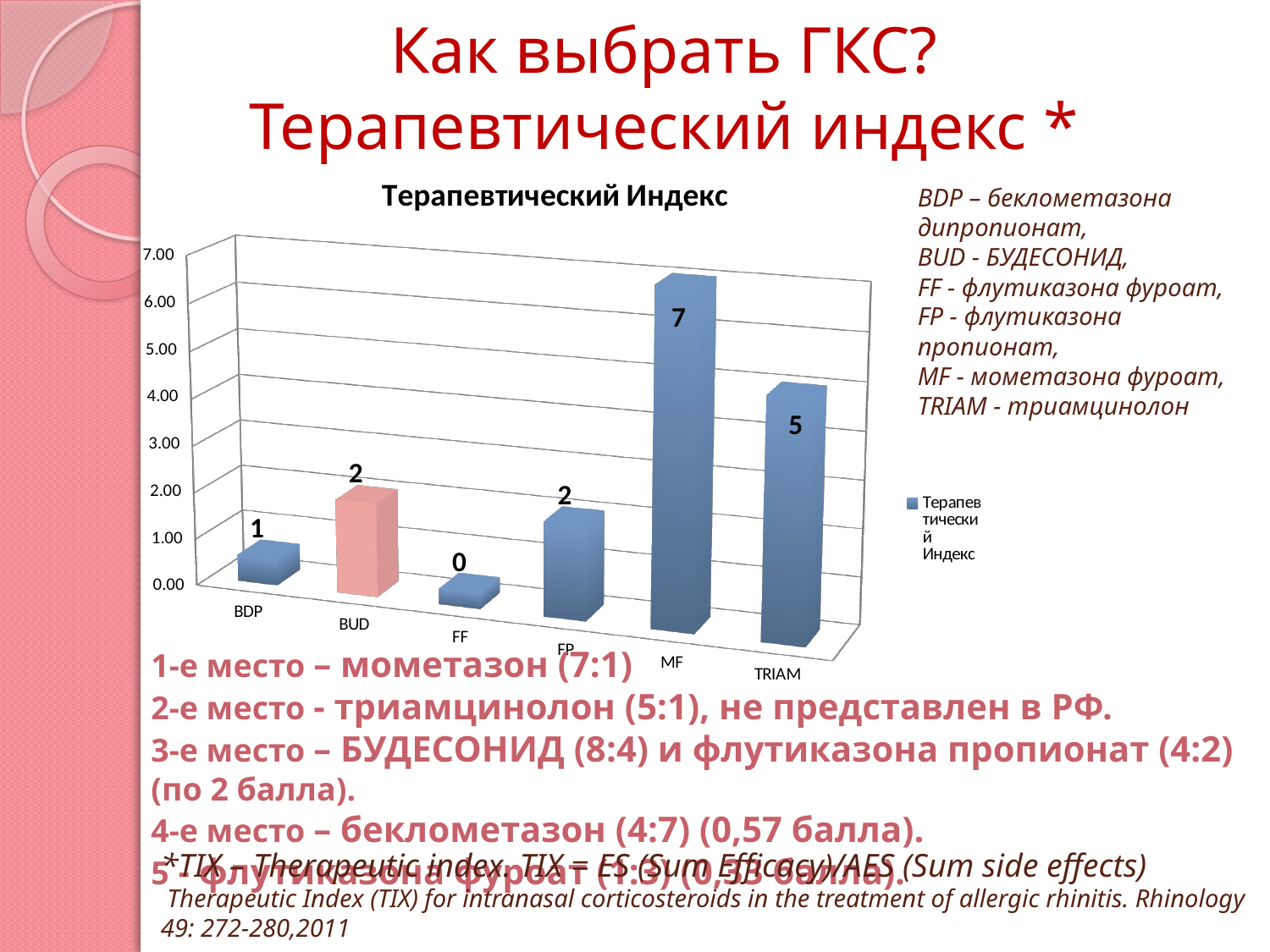
What is the value shown for FF in the chart? 0 How many categories are shown on the x axis of the chart? 6 How many series does the legend list? 1 Which category's bar is coloured pink instead of blue? BUD Which category has the lowest value in the chart? FF What is the difference between the values for MF and TRIAM? 2 What is the value shown for MF in the chart? 7 What is the value shown for TRIAM in the chart? 5 What is the value shown for BDP in the chart? 1 Which has a larger value, BUD or BDP? BUD Which category has the highest value in the chart? MF What kind of chart is shown on the slide? Bar chart